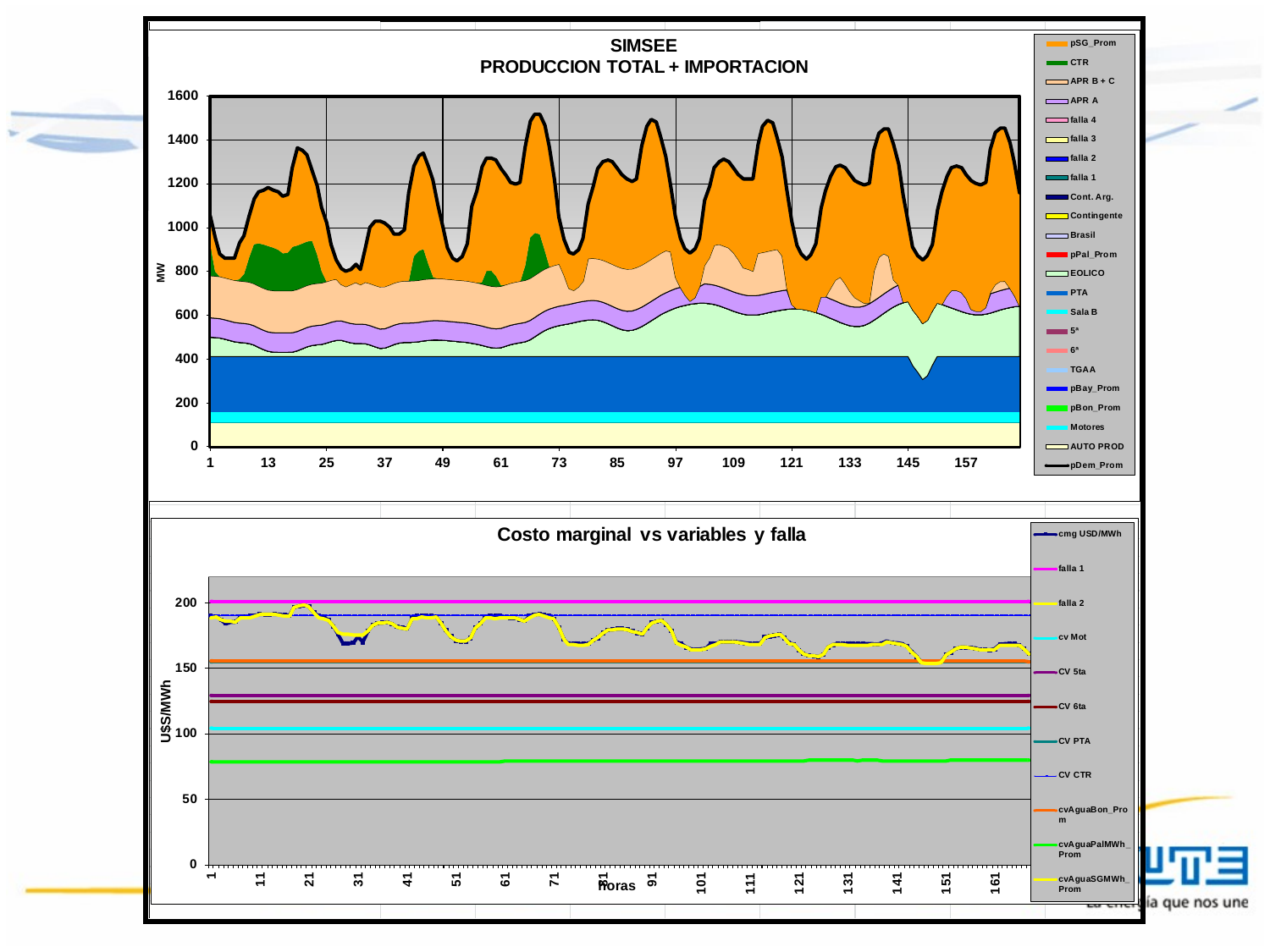
How many series does the legend of the bottom chart 'Costo marginal vs variables y falla' list? 11 In the bottom chart 'Costo marginal vs variables y falla', what is the label on the vertical axis? U$S/MWh In the bottom chart 'Costo marginal vs variables y falla', is the cvAguaPalMWh_Prom line greater or less than 100? less In the top chart 'SIMSEE PRODUCCION TOTAL + IMPORTACION', what is the label on the vertical axis? MW In the top chart 'SIMSEE PRODUCCION TOTAL + IMPORTACION', is the highest peak of the pDem_Prom line greater or less than 1400? greater In the bottom chart 'Costo marginal vs variables y falla', does the cmg USD/MWh line generally rise or fall from hour 1 to hour 161? fall How many series does the legend of the top chart 'SIMSEE PRODUCCION TOTAL + IMPORTACION' list? 23 What kind of chart is the bottom chart titled 'Costo marginal vs variables y falla'? line chart In the top chart 'SIMSEE PRODUCCION TOTAL + IMPORTACION', is the lowest point of the pDem_Prom line greater or less than 1000? less What kind of chart is the top chart titled 'SIMSEE PRODUCCION TOTAL + IMPORTACION'? stacked area chart In the top chart 'SIMSEE PRODUCCION TOTAL + IMPORTACION', which is larger: the pDem_Prom peak near hour 69 or the pDem_Prom peak near hour 13? the peak near hour 69